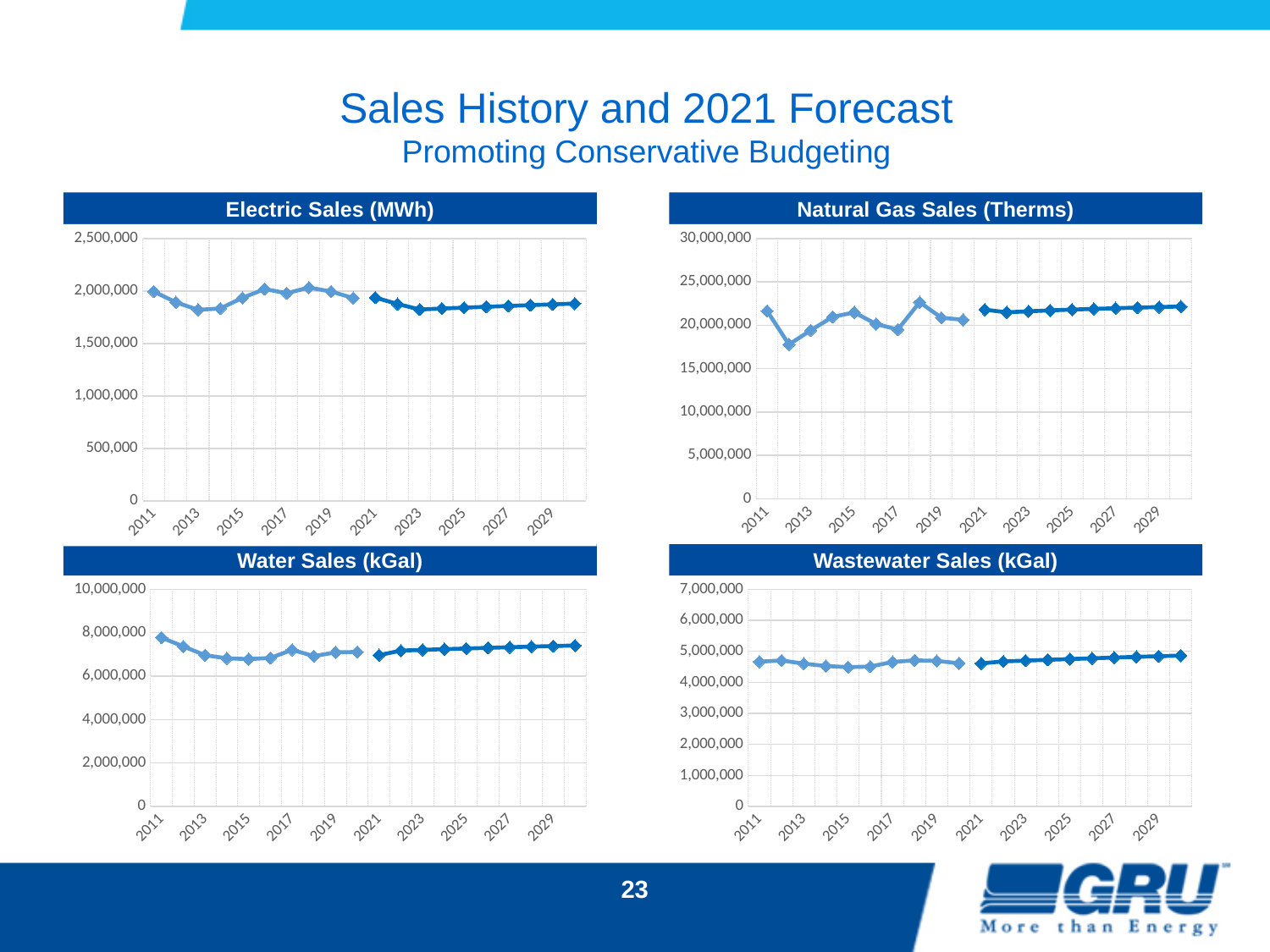
How many charts are shown on the slide? 4 In the Water Sales (kGal) chart, is the value for 2011 greater or less than 6,000,000? greater In the Natural Gas Sales (Therms) chart, which year has the lowest value? 2012 In the Wastewater Sales (kGal) chart, do the values rise or fall from 2021 to 2030? rise In the Electric Sales (MWh) chart, is the value for 2014 greater or less than 2,000,000? less What is the title of the chart in the top right of the slide? Natural Gas Sales (Therms) In the Water Sales (kGal) chart, which year has the highest value? 2011 In the Wastewater Sales (kGal) chart, is the value for 2011 greater or less than 5,000,000? less What kind of chart is the Electric Sales (MWh) chart? line chart In the Electric Sales (MWh) chart, do the values rise or fall from 2011 to 2014? fall